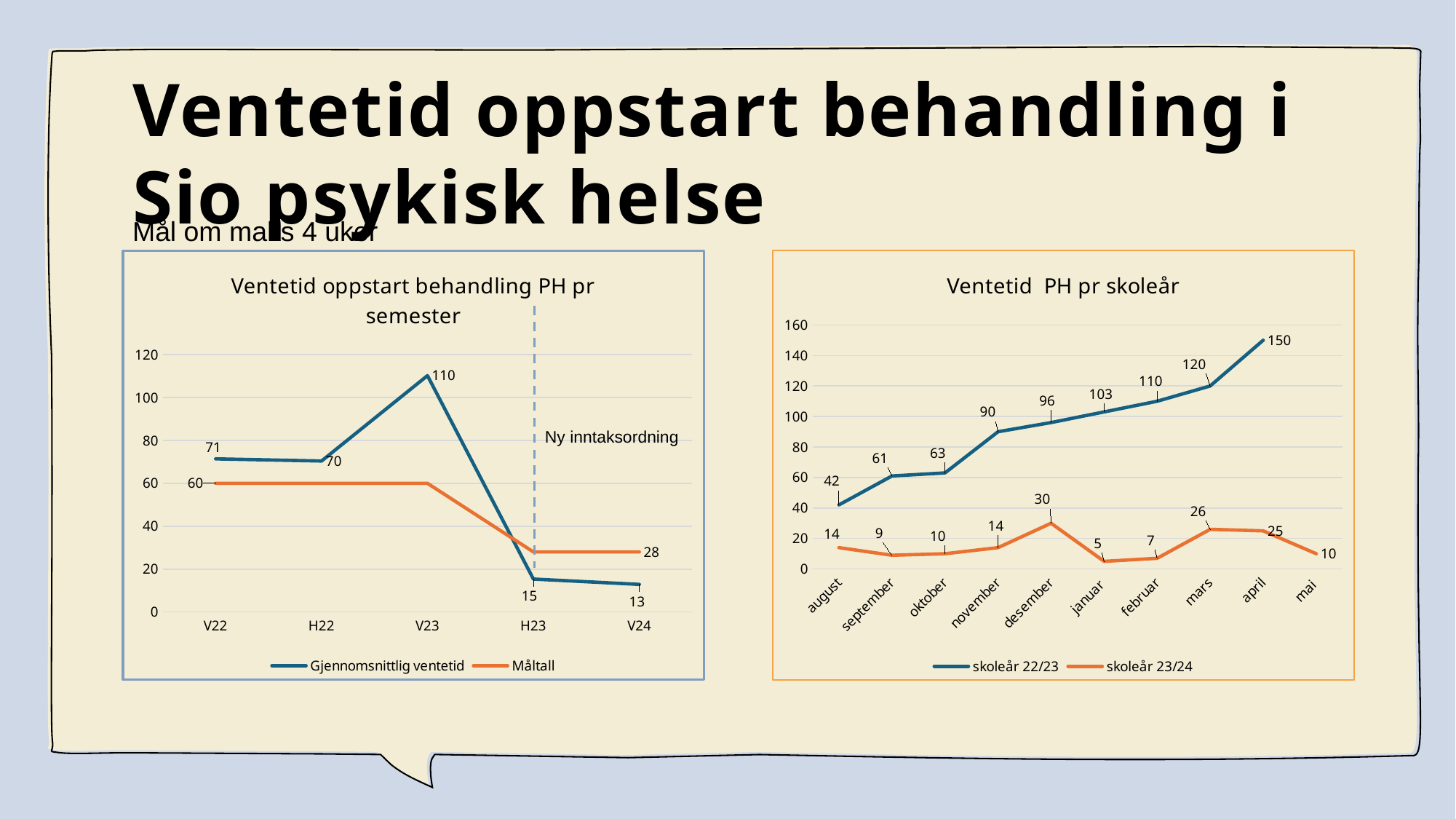
In the chart 'Ventetid oppstart behandling PH pr semester', what kind of chart is shown? Line chart In the chart 'Ventetid PH pr skoleår', how many months are shown on the x axis? 10 In the chart 'Ventetid oppstart behandling PH pr semester', what is the difference between the Gjennomsnittlig ventetid for V23 and H23? 95 In the chart 'Ventetid oppstart behandling PH pr semester', what is the Gjennomsnittlig ventetid value for V24? 13 In the chart 'Ventetid oppstart behandling PH pr semester', how many series does the legend list? 2 In the chart 'Ventetid oppstart behandling PH pr semester', which semester has the highest Gjennomsnittlig ventetid? V23 In the chart 'Ventetid PH pr skoleår', which is larger for mars: skoleår 22/23 or skoleår 23/24? skoleår 22/23 In the chart 'Ventetid PH pr skoleår', which month has the lowest skoleår 23/24 value? januar In the chart 'Ventetid PH pr skoleår', does the skoleår 22/23 series rise or fall from august to april? Rise In the chart 'Ventetid oppstart behandling PH pr semester', what is the Gjennomsnittlig ventetid value for V23? 110 In the chart 'Ventetid PH pr skoleår', what is the skoleår 22/23 value for januar? 103 In the chart 'Ventetid PH pr skoleår', what is the skoleår 23/24 value for desember? 30